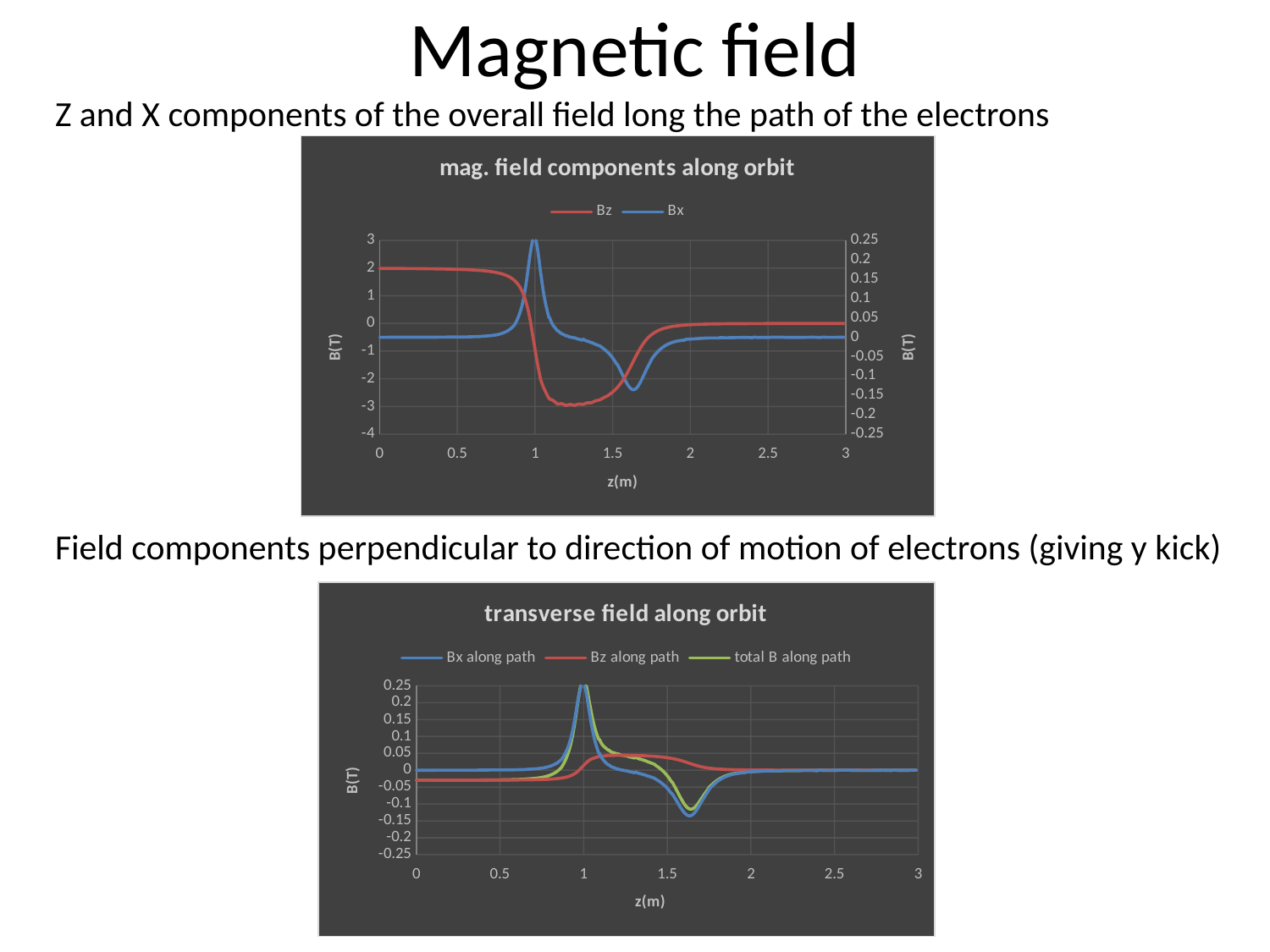
In the bottom chart "transverse field along orbit", does Bx along path rise or fall between z = 1 and z = 1.6? fall How many series does the legend of the bottom chart "transverse field along orbit" list? 3 In the top chart "mag. field components along orbit", is the value of Bz at z = 0 on the left axis greater or less than 1? greater What is the x-axis label of the top chart "mag. field components along orbit"? z(m) In the bottom chart "transverse field along orbit", is the peak value of Bx along path at z = 1 greater or less than 0.2? greater In the top chart "mag. field components along orbit", does Bz rise or fall between z = 0.5 and z = 1.2? fall In the bottom chart "transverse field along orbit", is the value of Bz along path at z = 0 greater or less than 0? less In the bottom chart "transverse field along orbit", which series is drawn in green? total B along path How many series does the legend of the top chart "mag. field components along orbit" list? 2 What kind of chart is the top chart titled "mag. field components along orbit"? line chart